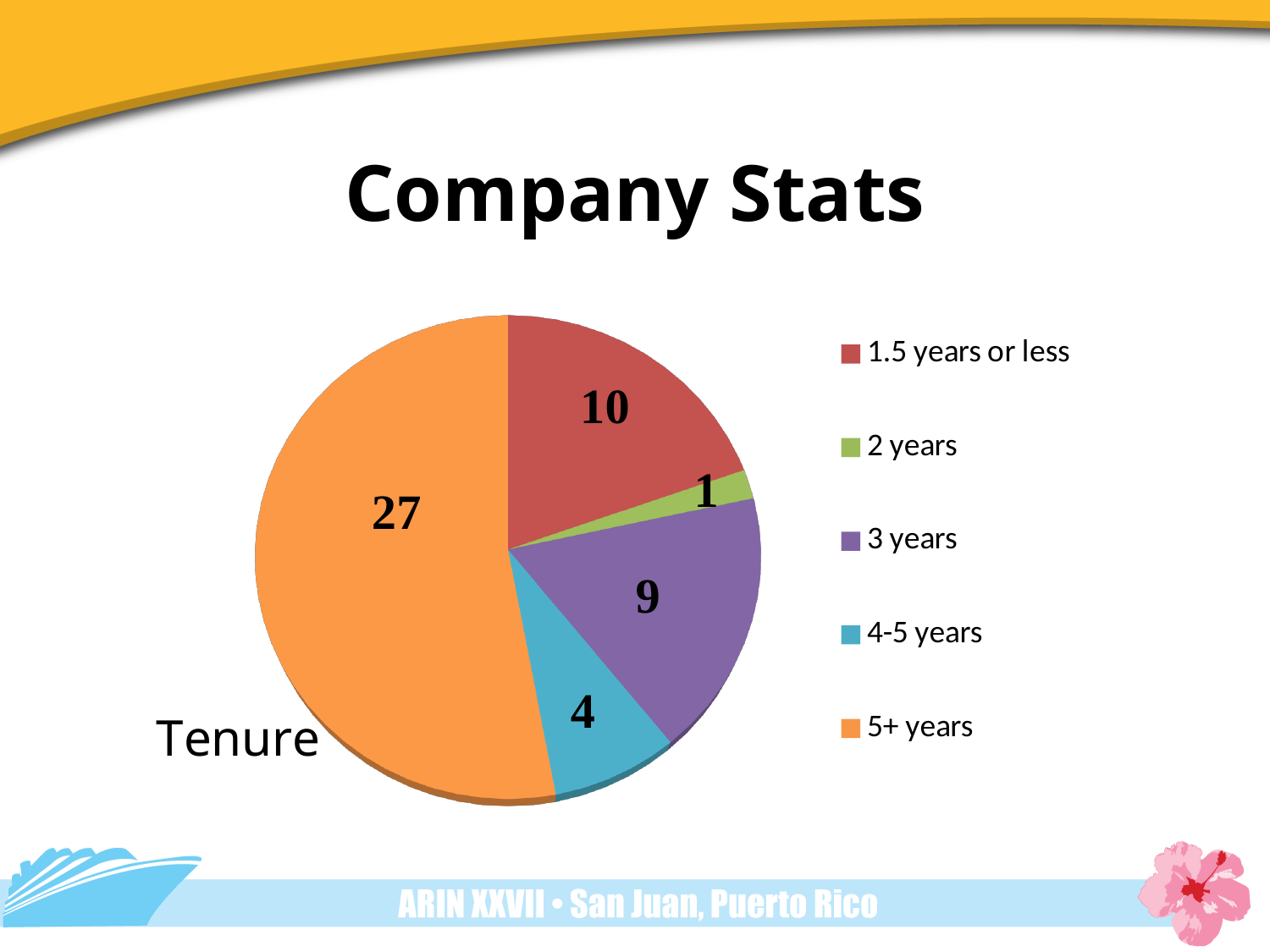
What is the value for the 5+ years slice? 27 What is the value for the 4-5 years slice? 4 Which tenure category has the largest slice? 5+ years What type of chart is shown on the slide? pie chart What label appears to the left of the pie chart? Tenure What is the value for the 2 years slice? 1 Which tenure category has the smallest slice? 2 years What is the value for the 3 years slice? 9 Which is larger, the 3 years slice or the 4-5 years slice? 3 years What is the value for the 1.5 years or less slice? 10 How many tenure categories are shown in the pie chart? 5 What is the difference between the 5+ years value and the 1.5 years or less value? 17